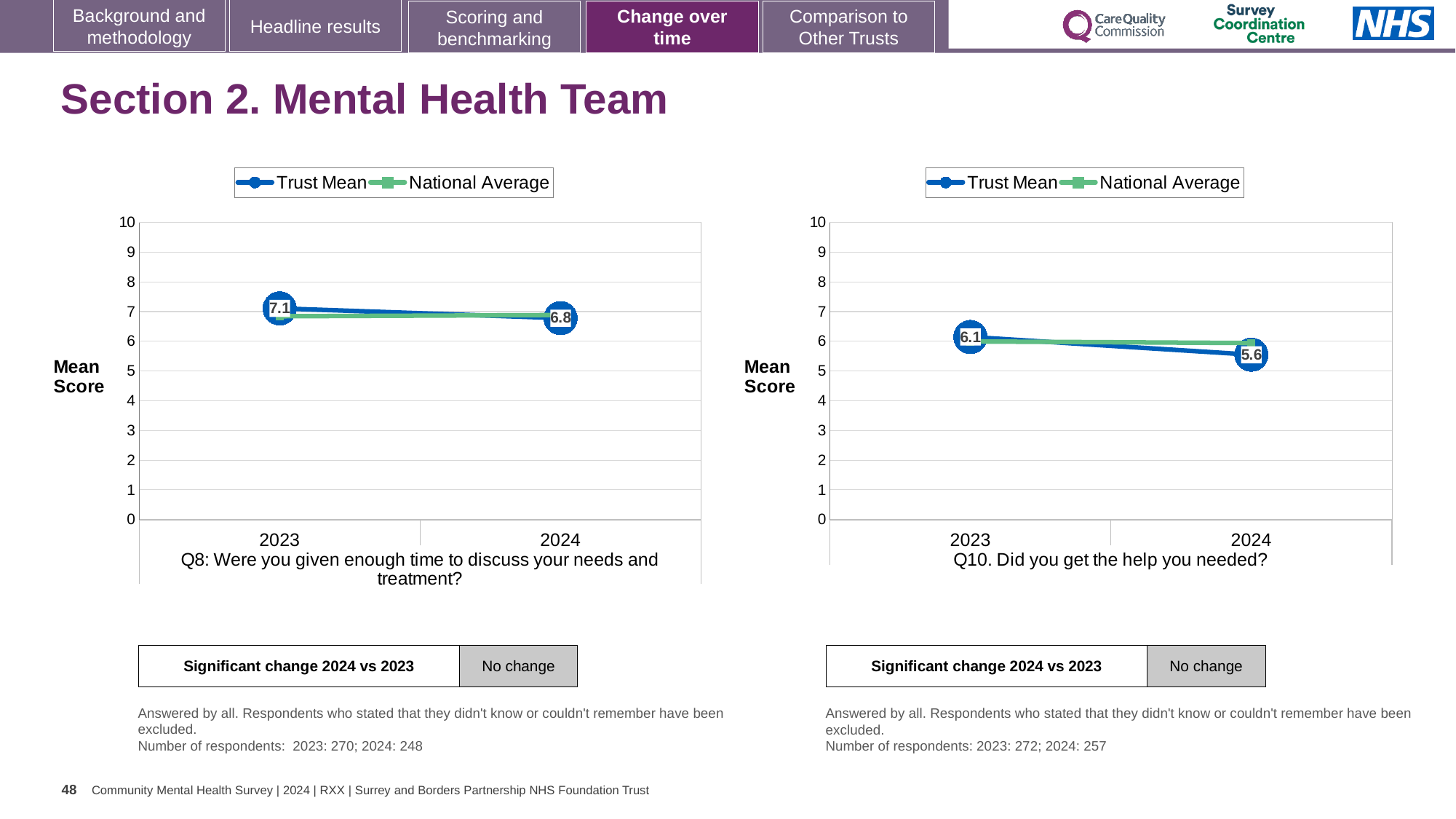
In the Q10 chart (right), does the Trust Mean rise or fall from 2023 to 2024? fall In the Q10 chart (right), by how much did the Trust Mean score fall from 2023 to 2024? 0.5 What type of chart is the Q8 chart on the left? line chart In the Q10 chart (right), what is the Trust Mean score for 2023? 6.1 In the Q10 chart (right), is the National Average value for 2024 greater or less than 5? greater How many series does the legend of the Q10 chart (right) list? 2 In the Q8 chart (left), what is the Trust Mean score for 2023? 7.1 In the Q8 chart (left), what is the Trust Mean score for 2024? 6.8 Which is larger: the 2023 Trust Mean in the Q8 chart (left) or the 2023 Trust Mean in the Q10 chart (right)? Q8 chart (7.1) How many years are shown on the x axis of the Q8 chart (left)? 2 In the Q8 chart (left), by how much did the Trust Mean score change from 2023 to 2024? 0.3 In the Q10 chart (right), what is the Trust Mean score for 2024? 5.6